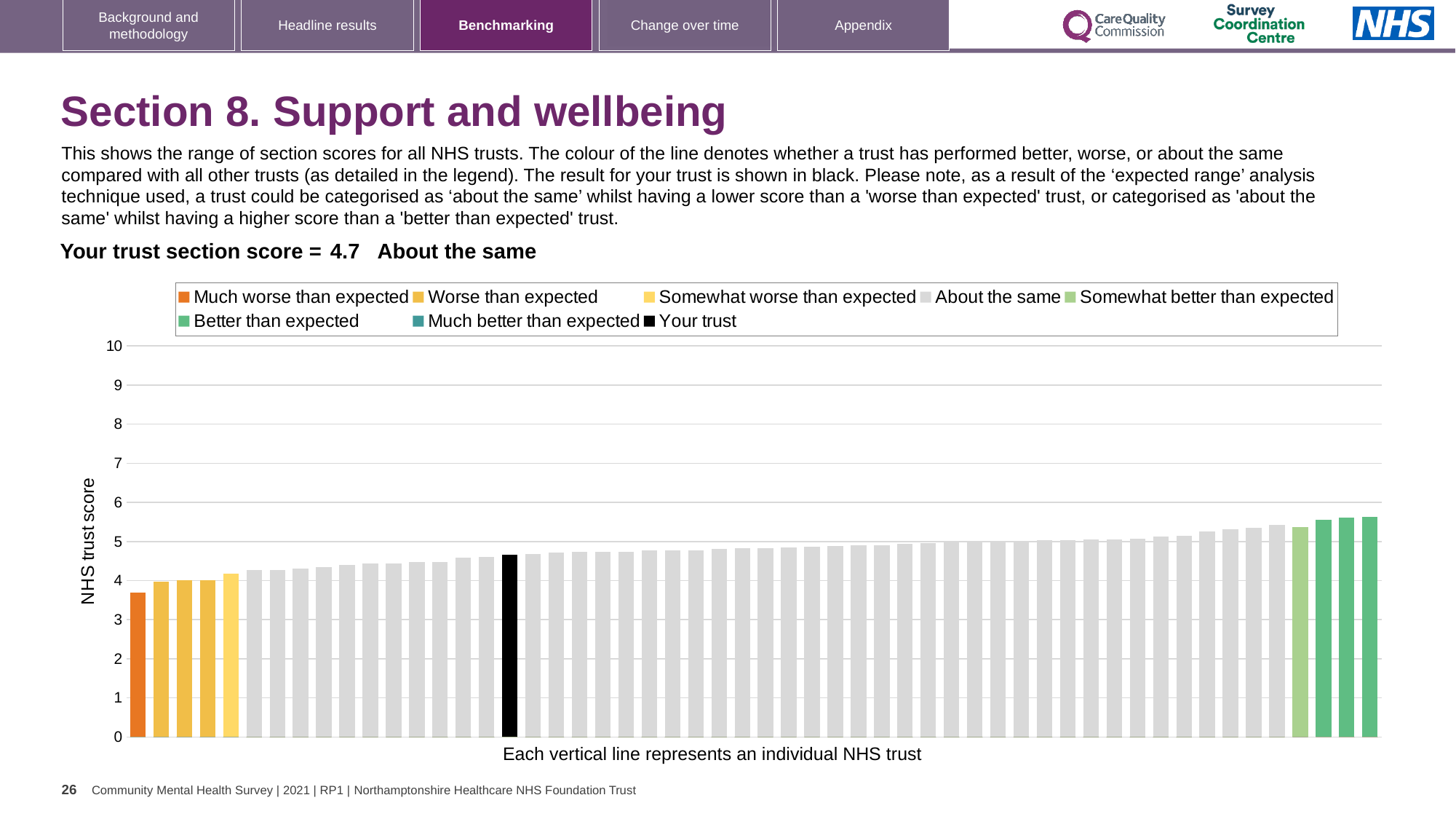
How many entries does the chart legend list? 8 Do the bar values rise or fall from left to right along the x axis? rise Is the value of the lowest bar (the 'Much worse than expected' trust) greater or less than 4? less Is the value for your trust's bar greater or less than 5? less Is the value of the highest bar in the chart greater or less than 6? less How many bars are coloured as 'Much worse than expected'? 1 Which category is your trust placed in according to the slide? About the same How many bars are coloured as 'Better than expected'? 3 What is the section score for your trust shown on the slide? 4.7 What is the label on the vertical axis of the chart? NHS trust score Is your trust's bar higher or lower than the 'Much worse than expected' bar? higher What kind of chart is shown on the slide? bar chart